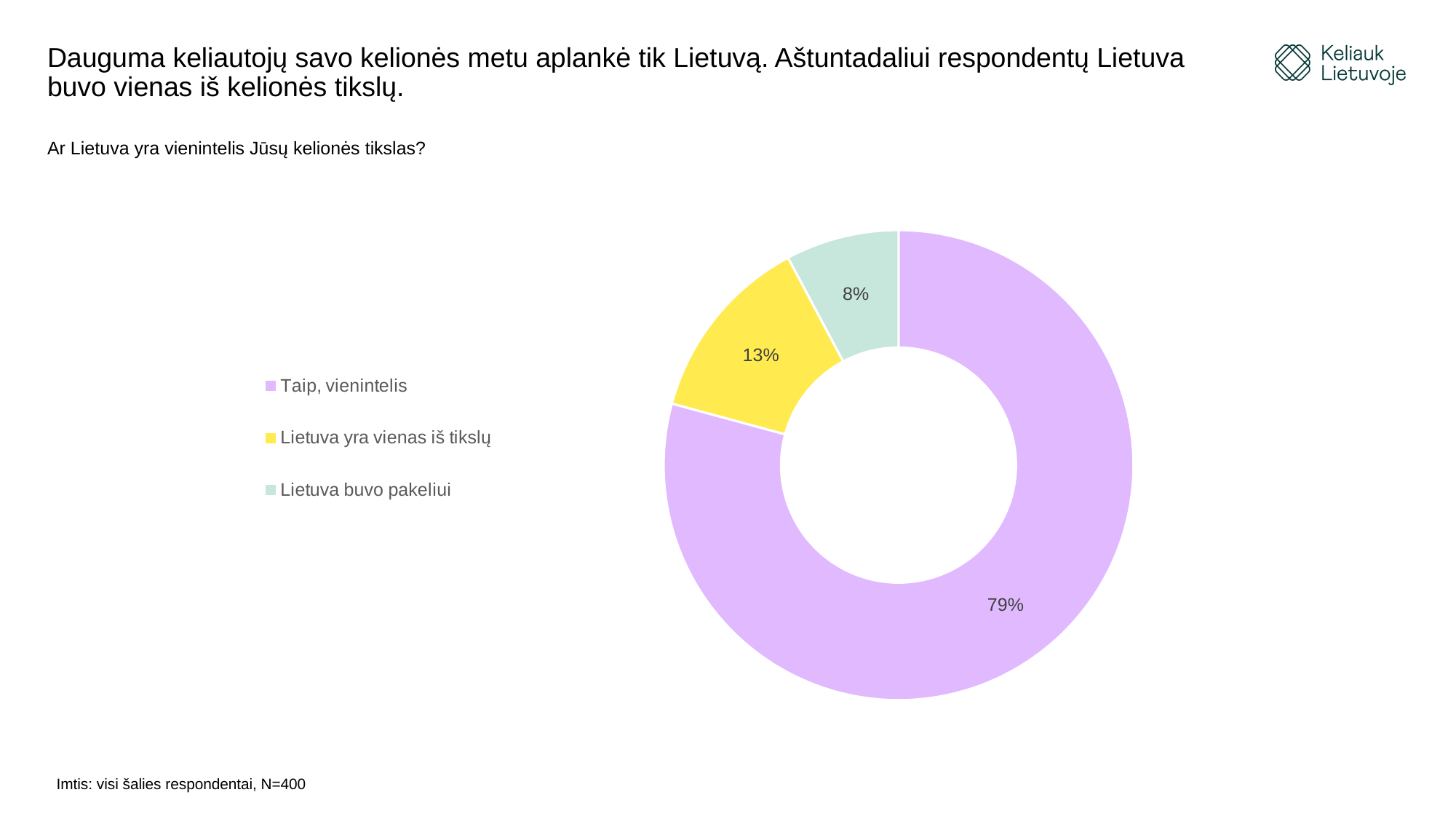
Which is larger: the share for "Lietuva yra vienas iš tikslų" or for "Lietuva buvo pakeliui"? Lietuva yra vienas iš tikslų What kind of chart is shown on the slide? Pie chart (doughnut) What share of respondents answered "Lietuva buvo pakeliui"? 8% What is the sample size stated on the slide? N=400 What is the difference in percentage points between "Lietuva yra vienas iš tikslų" and "Lietuva buvo pakeliui"? 5 percentage points Which category has the largest share of the pie? Taip, vienintelis How many categories does the pie chart show? 3 What share of respondents answered "Taip, vienintelis"? 79% What share of respondents answered "Lietuva yra vienas iš tikslų"? 13% Which category has the smallest share of the pie? Lietuva buvo pakeliui What is the difference in percentage points between "Taip, vienintelis" and "Lietuva yra vienas iš tikslų"? 66 percentage points What colour is the slice for "Lietuva yra vienas iš tikslų"? Yellow